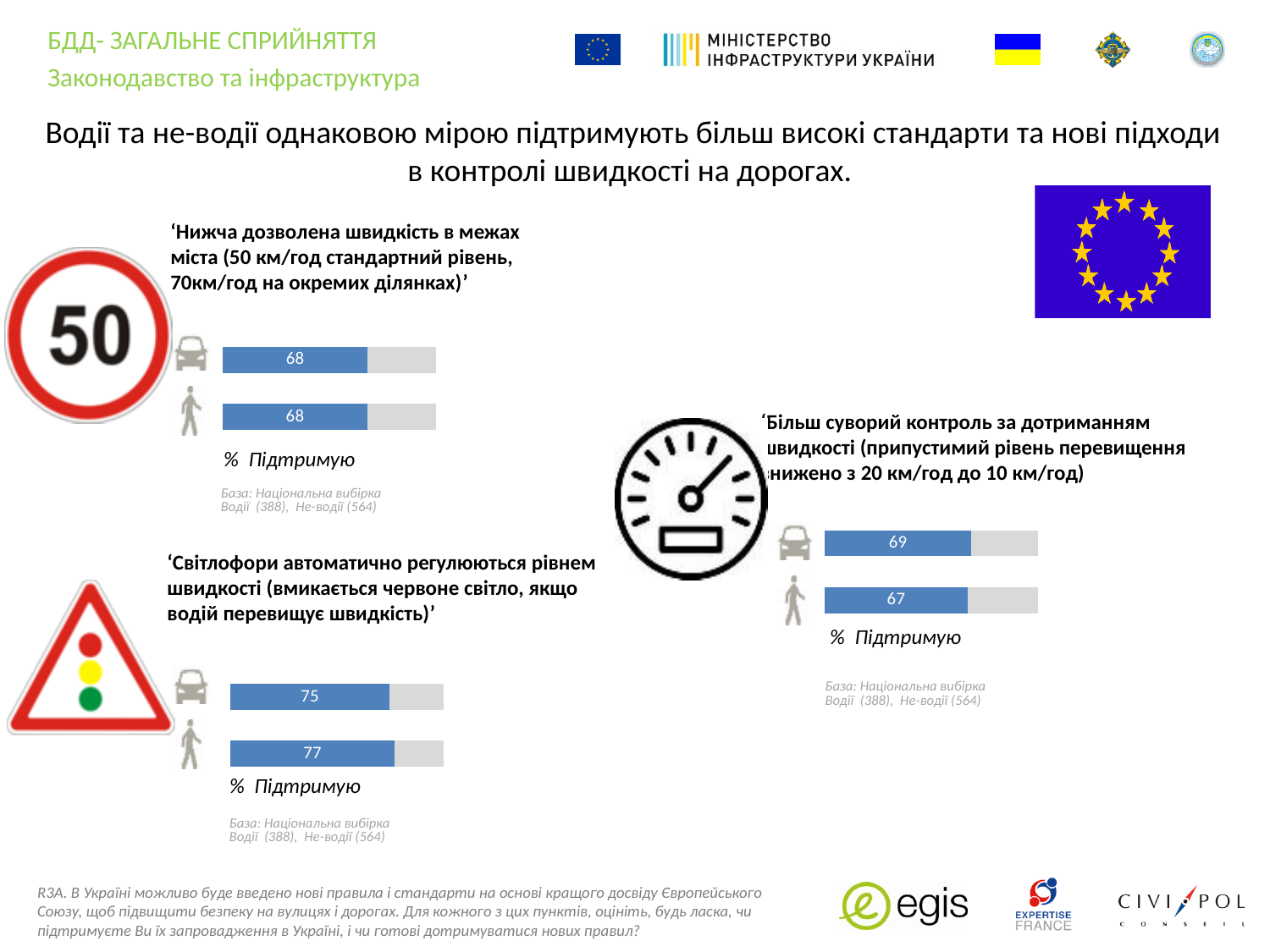
What type of chart is used to show the support percentages on this slide? Bar chart How many bars does each of the three charts on the slide contain? 2 In the chart for 'Світлофори автоматично регулюються рівнем швидкості' (bottom left), what is the difference between the non-driver and driver values? 2 In the chart for 'Світлофори автоматично регулюються рівнем швидкості' (bottom left), what is the value for non-drivers (pedestrian icon)? 77 In the chart for 'Нижча дозволена швидкість в межах міста' (top left), what percentage of drivers (car icon) support the measure? 68 In the chart for 'Світлофори автоматично регулюються рівнем швидкості' (bottom left), which group has the higher support value, drivers or non-drivers? Non-drivers In the chart for 'Більш суворий контроль за дотриманням швидкості' (right), what is the value for non-drivers (pedestrian icon)? 67 In the chart for 'Більш суворий контроль за дотриманням швидкості' (right), what is the value for drivers (car icon)? 69 In the chart for 'Більш суворий контроль за дотриманням швидкості' (right), which group has the higher support value, drivers or non-drivers? Drivers In the chart for 'Нижча дозволена швидкість в межах міста' (top left), what percentage of non-drivers (pedestrian icon) support the measure? 68 In the chart for 'Світлофори автоматично регулюються рівнем швидкості' (bottom left), what is the value for drivers (car icon)? 75 In the chart for 'Більш суворий контроль за дотриманням швидкості' (right), what is the difference between the driver and non-driver values? 2